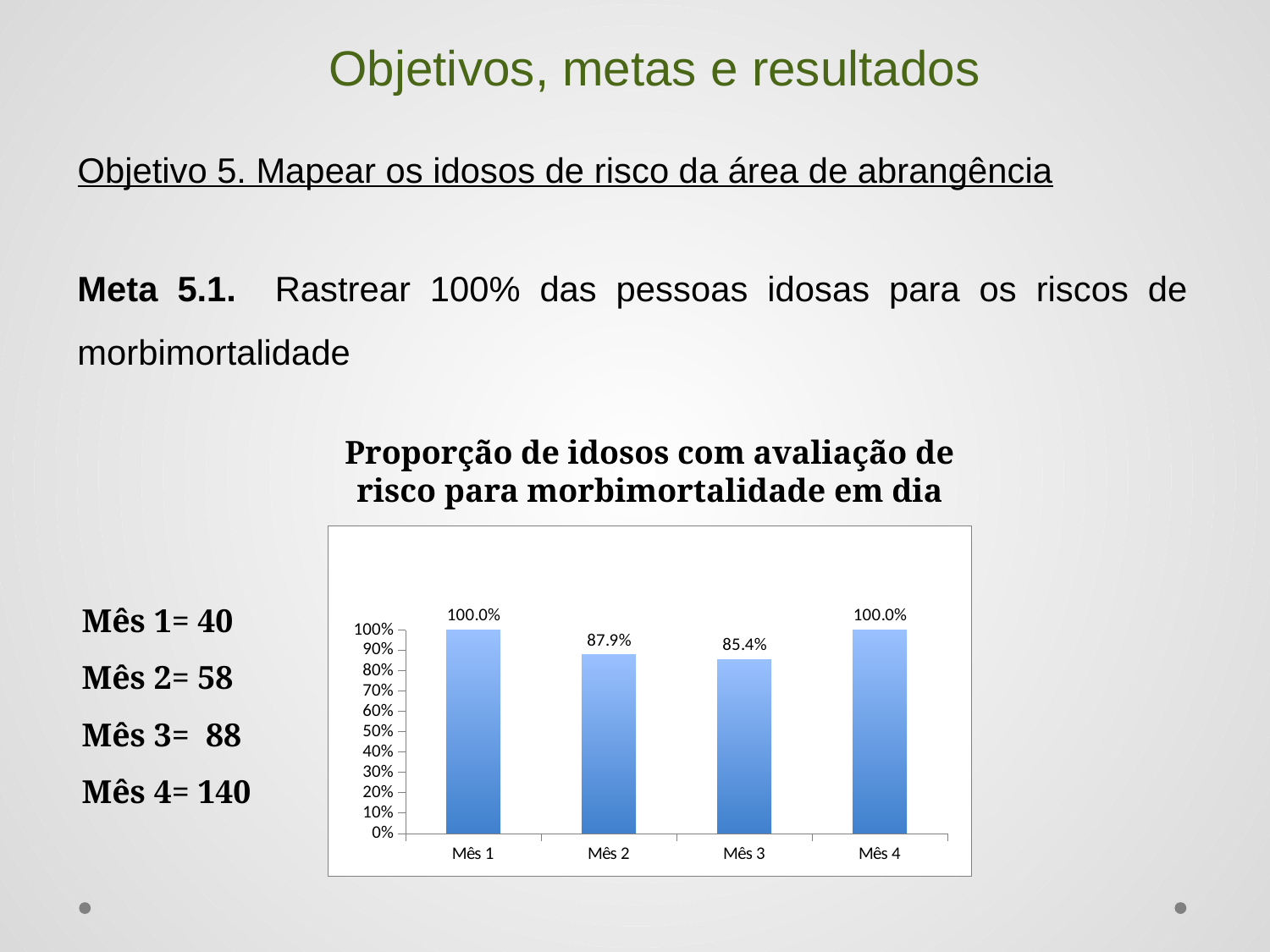
Is the value for Mês 3 greater or less than 90%? less What is the value for Mês 1 in the chart? 100.0% Do the values rise or fall from Mês 1 to Mês 3? fall What is the title of the chart? Proporção de idosos com avaliação de risco para morbimortalidade em dia How many months are shown on the x axis of the chart? 4 What is the value for Mês 3 in the chart? 85.4% Which is larger, the value for Mês 2 or the value for Mês 3? Mês 2 What is the difference between the values for Mês 1 and Mês 3? 14.6% What is the difference between the values for Mês 2 and Mês 3? 2.5% What is the value for Mês 2 in the chart? 87.9% Which month has the lowest value in the chart? Mês 3 What kind of chart is shown on the slide? bar chart